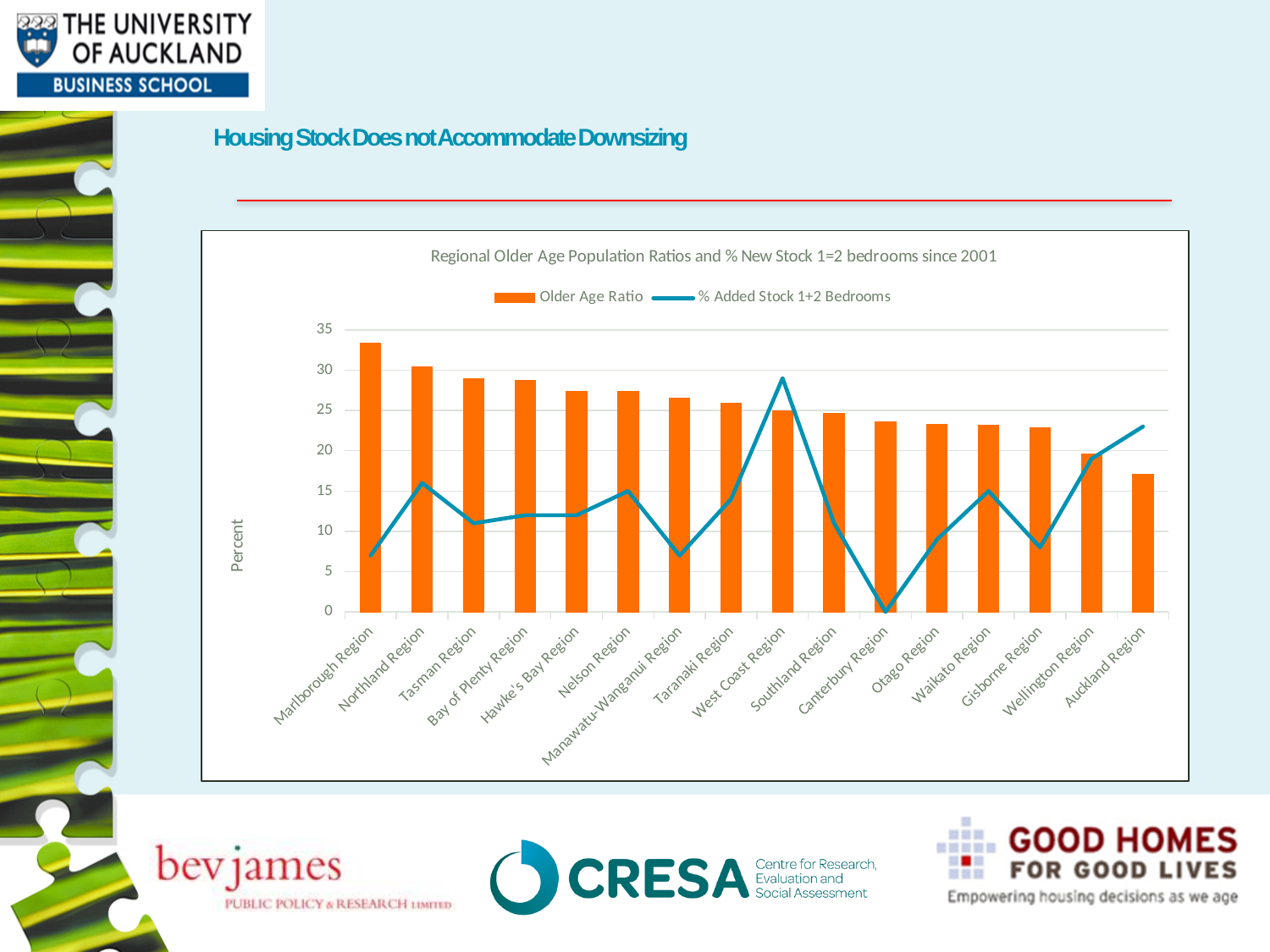
What is the label on the chart's vertical axis? Percent Do the Older Age Ratio bars generally rise or fall from left to right across the regions? fall Is the % Added Stock 1+2 Bedrooms value for Manawatu-Wanganui Region greater or less than 10? less How many series does the chart's legend list? 2 Which region has the highest Older Age Ratio bar? Marlborough Region Which region has the lowest Older Age Ratio bar? Auckland Region What kind of chart is shown on the slide? A combined bar and line chart Which region has the highest value on the % Added Stock 1+2 Bedrooms line? West Coast Region Which is larger, the Older Age Ratio for Northland Region or for Wellington Region? Northland Region How many regions are shown along the x axis of the chart? 16 Which region has the lowest value on the % Added Stock 1+2 Bedrooms line? Canterbury Region Is the Older Age Ratio for Marlborough Region greater or less than 30? greater